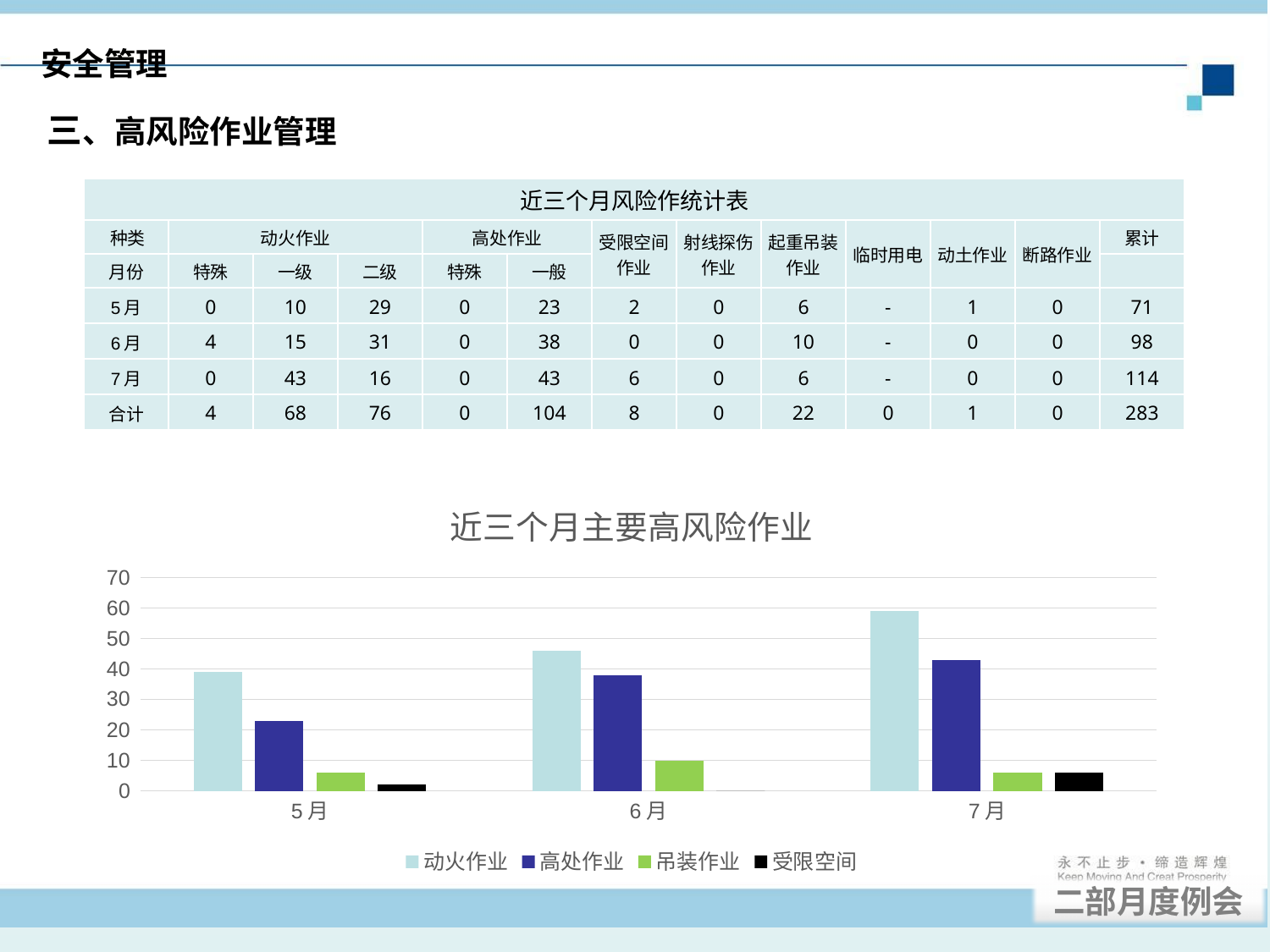
Which month has the highest value for 动火作业 in the chart? 7月 What kind of chart is shown on the slide? bar chart Is the value for 动火作业 in 7月 greater or less than 50? greater Do the values for 高处作业 rise or fall from 5月 to 7月? rise Which month has the lowest value for 动火作业 in the chart? 5月 What is the value for 吊装作业 in 6月? 10 Is the value for 高处作业 in 5月 greater or less than 30? less Do the values for 动火作业 rise or fall from 5月 to 7月? rise In 6月, which is larger, 动火作业 or 高处作业? 动火作业 How many series does the chart legend list? 4 How many months are shown on the x axis of the chart? 3 What is the title of the chart? 近三个月主要高风险作业